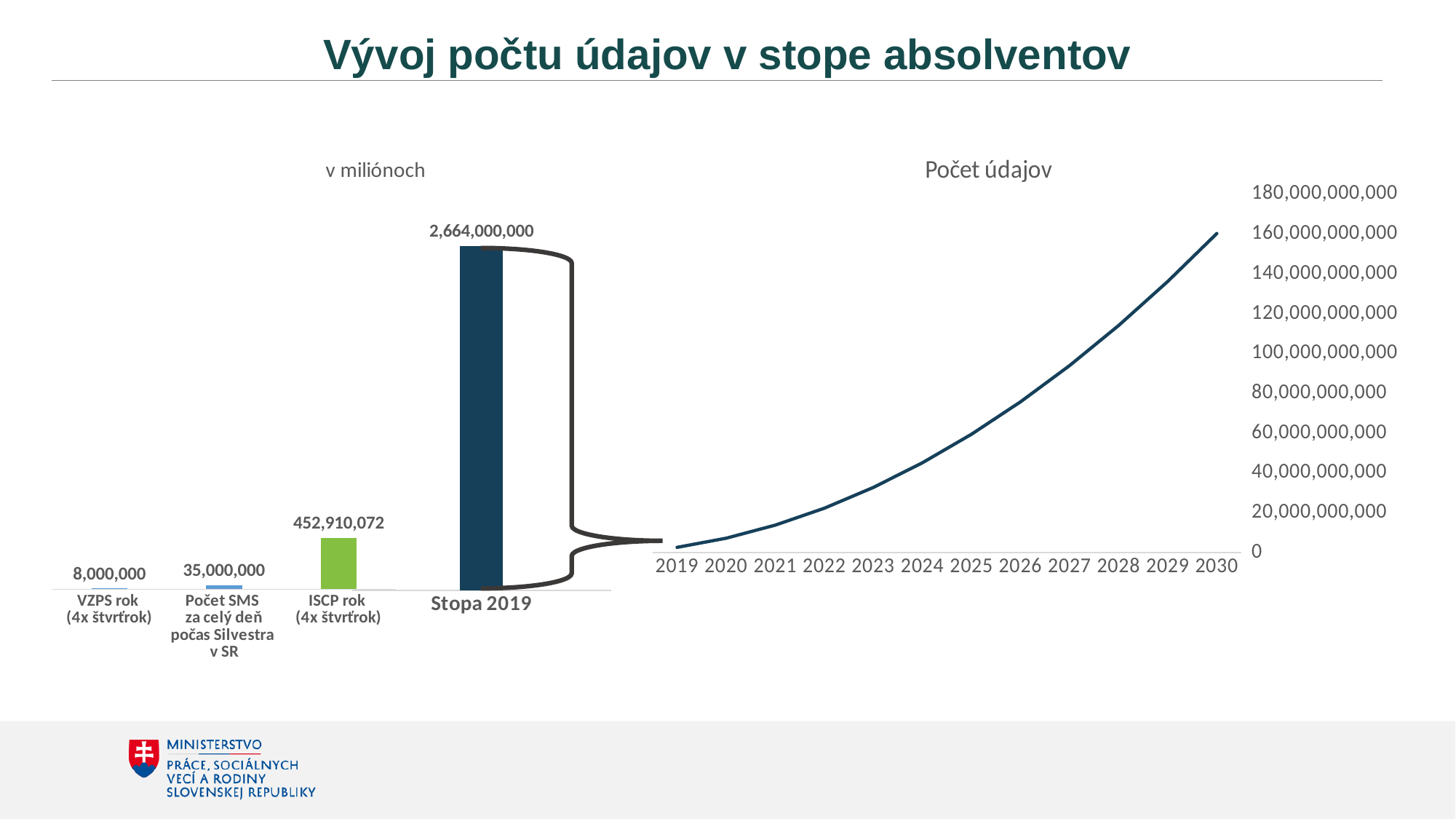
How many bars are shown on the left bar chart (v miliónoch)? 4 On the left bar chart (v miliónoch), what is the value for Stopa 2019? 2,664,000,000 On the left bar chart (v miliónoch), what is the value for VZPS rok (4x štvrťrok)? 8,000,000 On the left bar chart (v miliónoch), which is larger: Počet SMS za celý deň počas Silvestra v SR or VZPS rok (4x štvrťrok)? Počet SMS za celý deň počas Silvestra v SR On the left bar chart (v miliónoch), which category has the highest value? Stopa 2019 On the left bar chart (v miliónoch), what is the value for Počet SMS za celý deň počas Silvestra v SR? 35,000,000 What kind of chart is the right chart titled Počet údajov? Line chart On the left bar chart (v miliónoch), which category has the lowest value? VZPS rok (4x štvrťrok) On the left bar chart (v miliónoch), what is the value for ISCP rok (4x štvrťrok)? 452,910,072 On the right chart (Počet údajov), is the value for 2030 greater or less than 140,000,000,000? greater On the left bar chart (v miliónoch), what is the difference between Stopa 2019 and ISCP rok (4x štvrťrok)? 2,211,089,928 On the right chart (Počet údajov), do the values rise or fall from 2019 to 2030? Rise